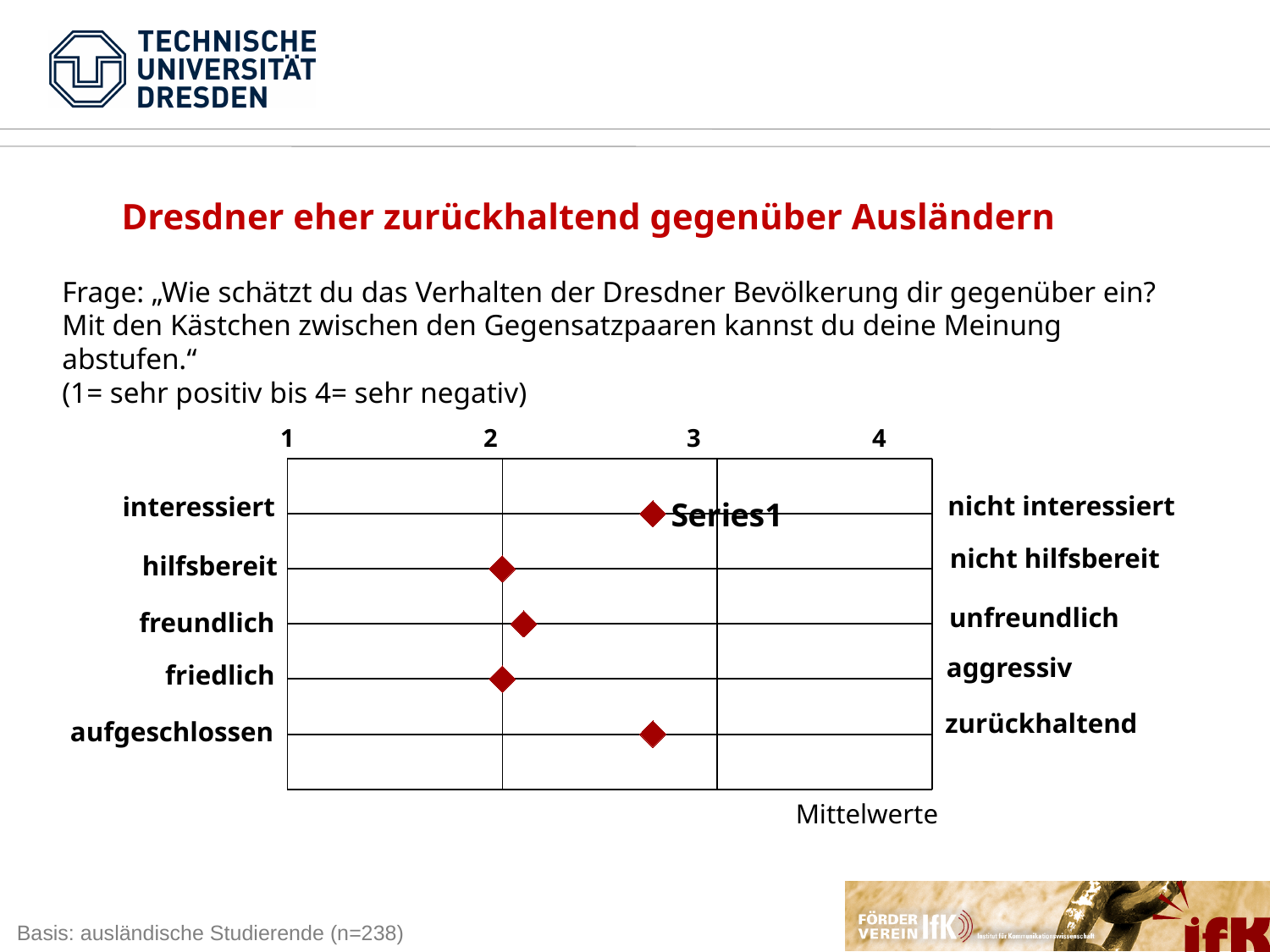
Is the value for 'aufgeschlossen' greater or less than 2? greater What label is shown below the chart's horizontal axis? Mittelwerte Is the value for 'aufgeschlossen' greater or less than 3? less Which has the larger value, 'aufgeschlossen' or 'friedlich'? aufgeschlossen Is the value for 'interessiert' greater or less than 3? less What kind of chart is shown on the slide? scatter (dot) chart How many categories (attribute pairs) are plotted on the chart? 5 Which has the larger value, 'interessiert' or 'hilfsbereit'? interessiert